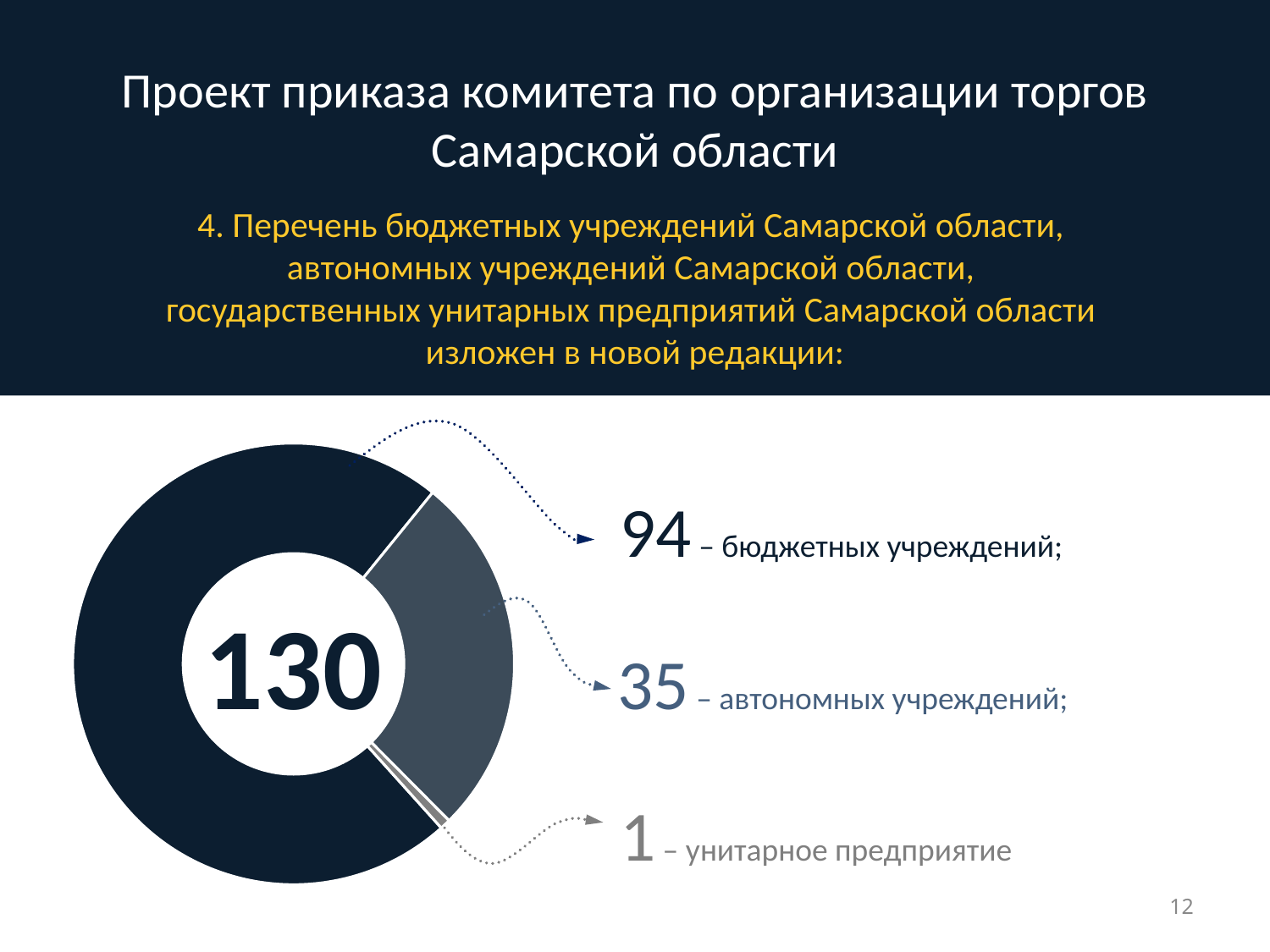
What is the sum of the three values shown around the donut chart? 130 Which category has the largest segment in the donut chart? бюджетных учреждений Which is larger: the value for бюджетных учреждений or for автономных учреждений? бюджетных учреждений What colour is the largest segment of the donut chart? Dark navy blue What is the value for бюджетных учреждений? 94 What is the value for автономных учреждений? 35 What is the value for унитарное предприятие? 1 What total is shown in the centre of the donut chart? 130 What is the difference between the number of бюджетных учреждений and автономных учреждений? 59 Which category has the smallest segment in the donut chart? унитарное предприятие What type of chart is shown on the slide? Donut (pie) chart How many categories does the donut chart show? 3